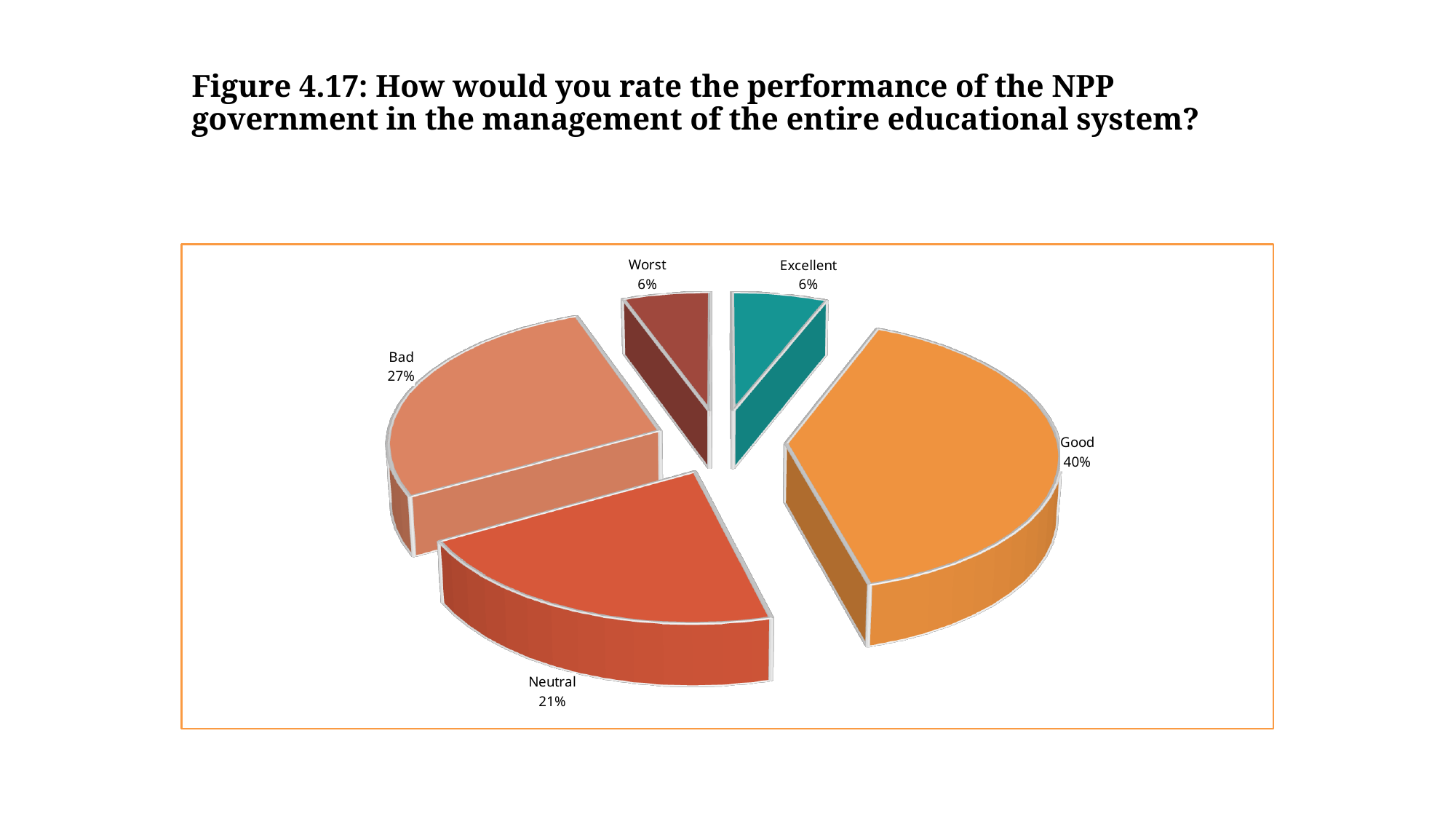
Which rating category has the largest share of the pie? Good What is the figure number given in the slide title? Figure 4.17 What percentage of respondents rated the performance as Excellent? 6% How many slices does the pie chart have? 5 What colour is the Good slice? orange What is the combined share of the Worst and Excellent slices? 12% What is the difference in percentage points between the Good and Bad slices? 13 Which slice is larger, Bad or Neutral? Bad What kind of chart is shown on the slide? pie chart What percentage of respondents gave a Neutral rating? 21% What percentage of respondents rated the performance as Bad? 27% What percentage of respondents rated the NPP government's performance as Good? 40%